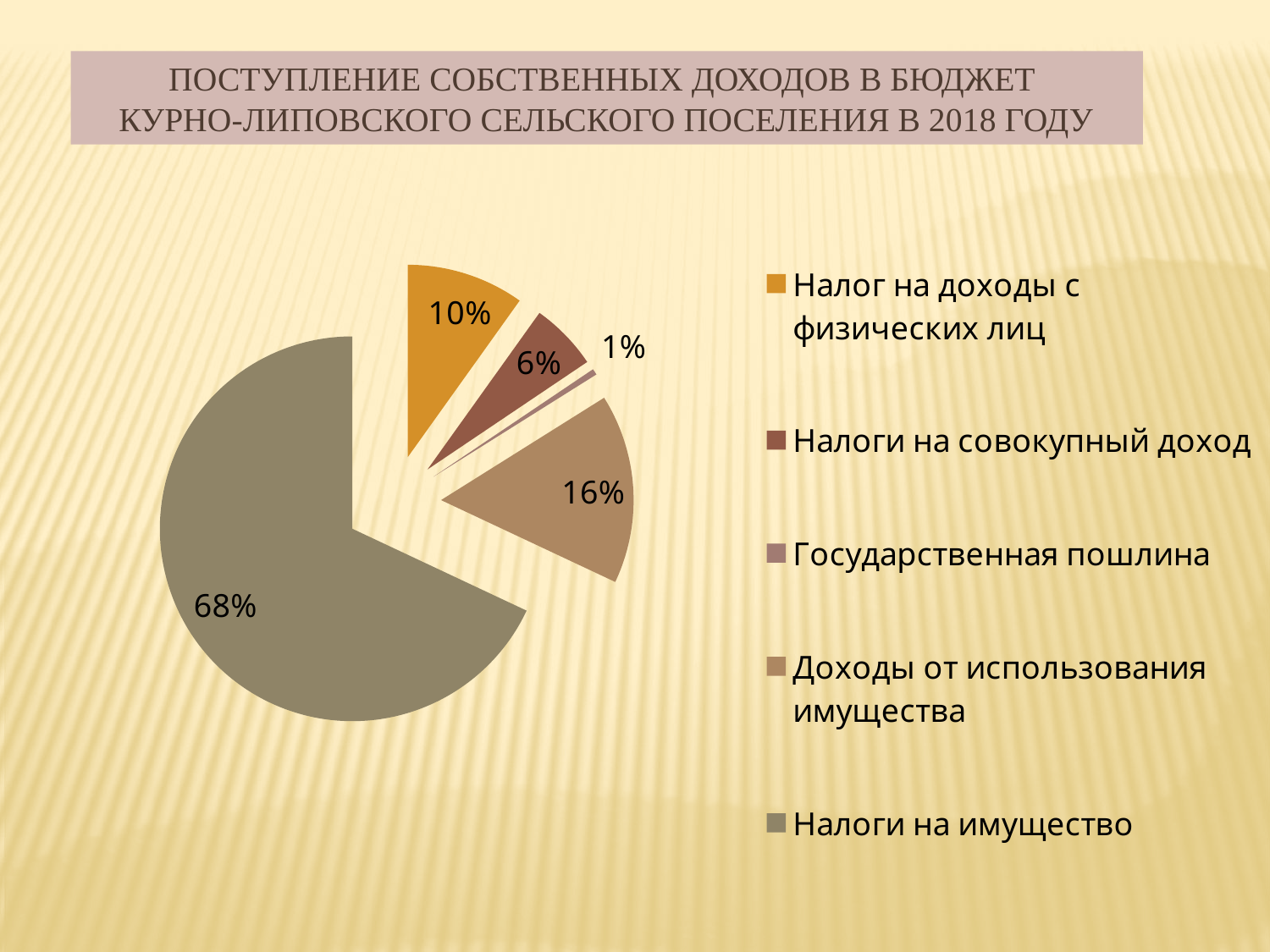
What is the value shown for Доходы от использования имущества? 16% What colour is the slice for Налог на доходы с физических лиц? orange Which category has the smallest slice of the pie? Государственная пошлина What is the value shown for Налог на доходы с физических лиц? 10% What kind of chart is shown on the slide? pie chart How many categories does the legend list? 5 What is the value shown for Налоги на совокупный доход? 6% What is the difference between the shares of Доходы от использования имущества and Налог на доходы с физических лиц? 6% Which is larger: the share for Налог на доходы с физических лиц or the share for Налоги на совокупный доход? Налог на доходы с физических лиц What is the value shown for Государственная пошлина? 1% What share of the pie does Налоги на имущество have? 68% Which category has the largest slice of the pie? Налоги на имущество